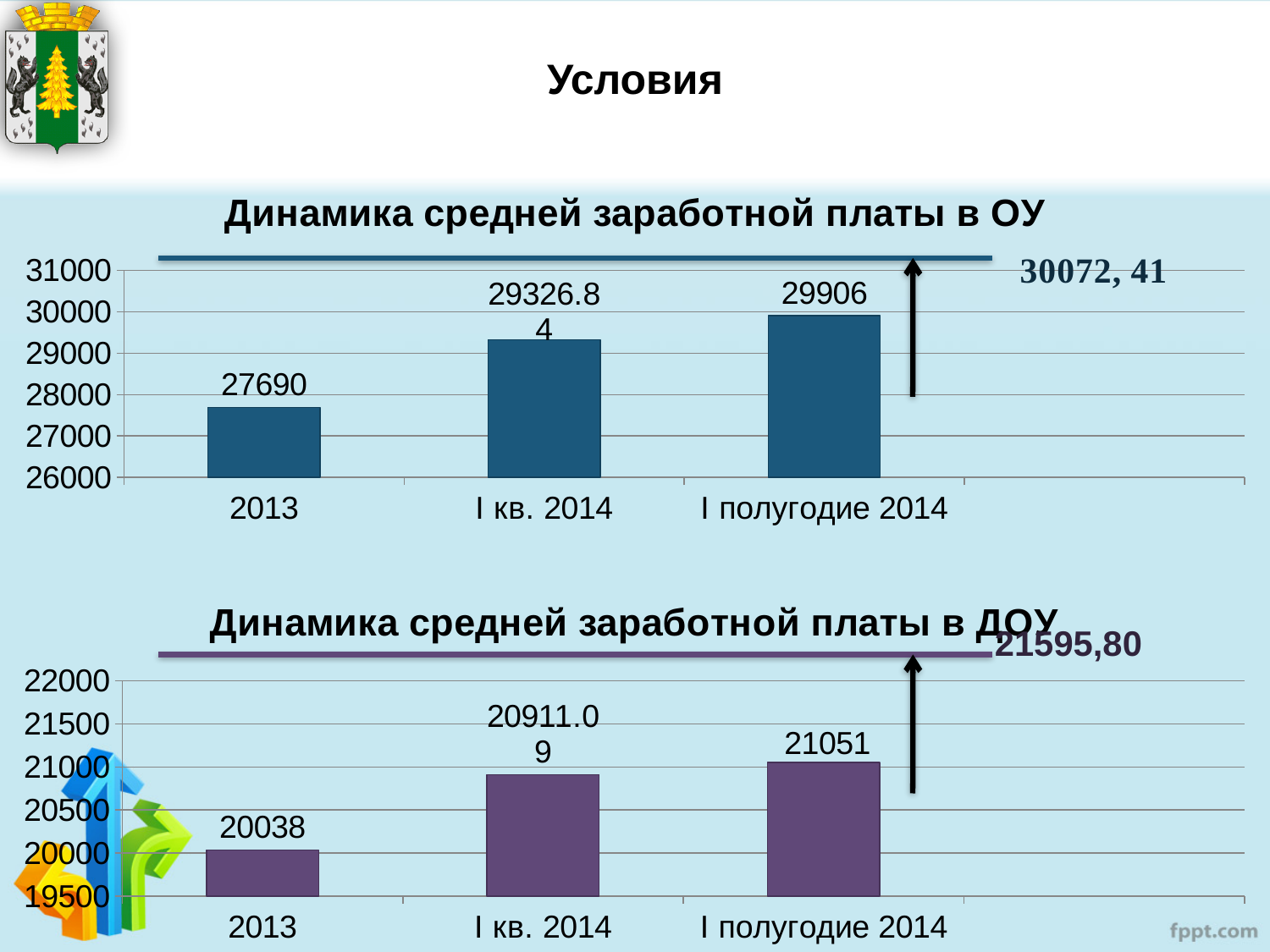
In the chart 'Динамика средней заработной платы в ДОУ', which is larger: the value for I кв. 2014 or the value for 2013? I кв. 2014 In the chart 'Динамика средней заработной платы в ДОУ', what is the value for I полугодие 2014? 21051 In the chart 'Динамика средней заработной платы в ОУ', what is the value for 2013? 27690 How many categories are shown on the x axis of the chart 'Динамика средней заработной платы в ОУ'? 3 Do the values in the chart 'Динамика средней заработной платы в ДОУ' rise or fall from 2013 to I полугодие 2014? rise In the chart 'Динамика средней заработной платы в ОУ', what is the value for I полугодие 2014? 29906 In the chart 'Динамика средней заработной платы в ДОУ', what is the value for 2013? 20038 In the chart 'Динамика средней заработной платы в ОУ', what is the value for I кв. 2014? 29326.84 In the chart 'Динамика средней заработной платы в ОУ', which category has the highest value? I полугодие 2014 In the chart 'Динамика средней заработной платы в ОУ', what is the difference between the values for I полугодие 2014 and 2013? 2216 In the chart 'Динамика средней заработной платы в ДОУ', which category has the lowest value? 2013 In the chart 'Динамика средней заработной платы в ДОУ', what is the difference between the values for I полугодие 2014 and 2013? 1013